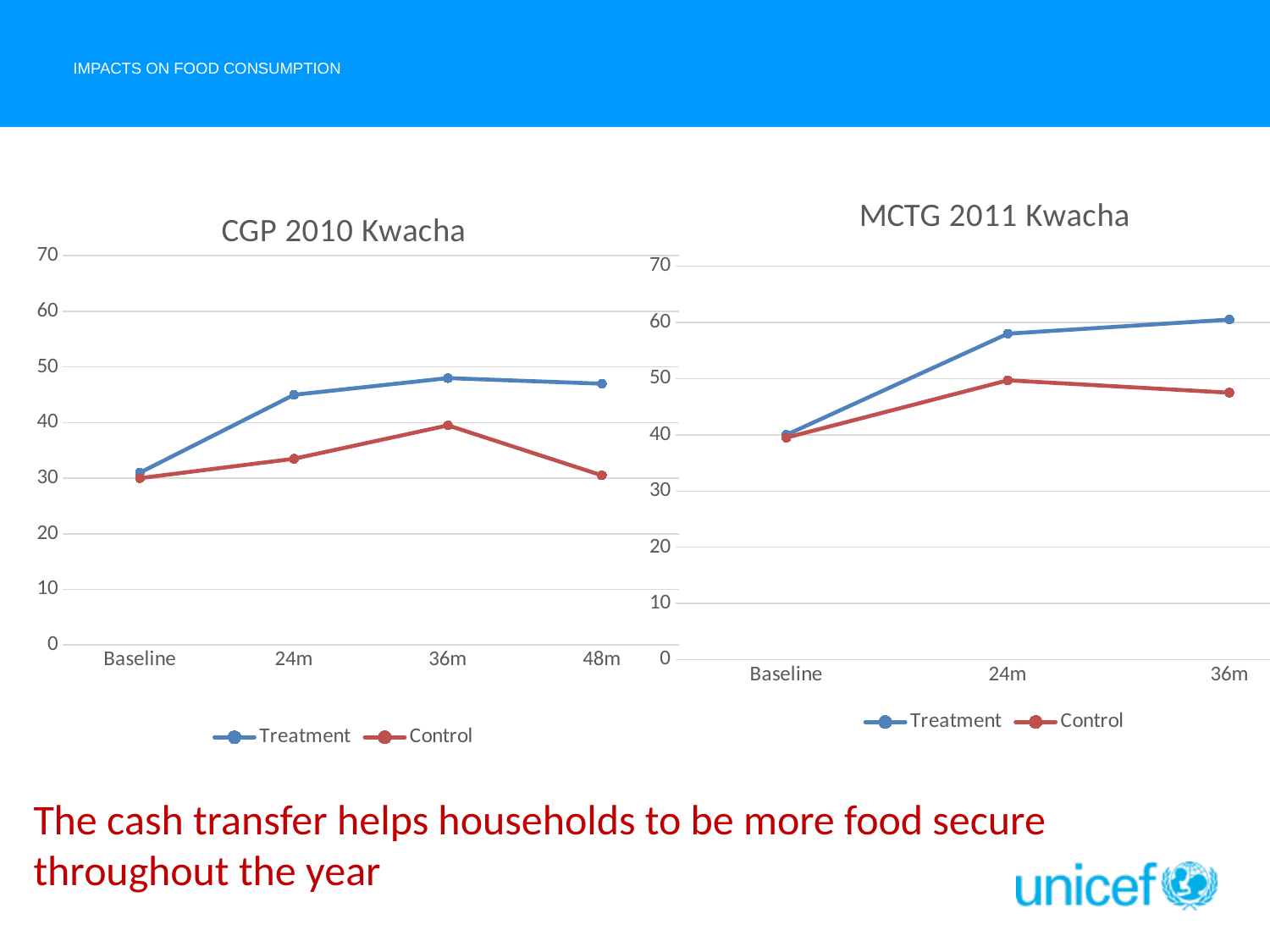
What is the title of the chart on the right side of the slide? MCTG 2011 Kwacha In the MCTG 2011 Kwacha chart, is the Treatment value at 24m greater or less than 50? greater In the CGP 2010 Kwacha chart, is the Treatment value at 24m greater or less than 40? greater In the CGP 2010 Kwacha chart, which series has the larger value at 36m, Treatment or Control? Treatment How many time points are shown on the x axis of the MCTG 2011 Kwacha chart? 3 How many time points are shown on the x axis of the CGP 2010 Kwacha chart? 4 In the MCTG 2011 Kwacha chart, is the Control value at 36m greater or less than 50? less What kind of chart is the CGP 2010 Kwacha chart? line chart In the MCTG 2011 Kwacha chart, does the Treatment series rise or fall from Baseline to 36m? rise How many series does the legend of the MCTG 2011 Kwacha chart list? 2 In the CGP 2010 Kwacha chart, at which time point is the Control series highest? 36m